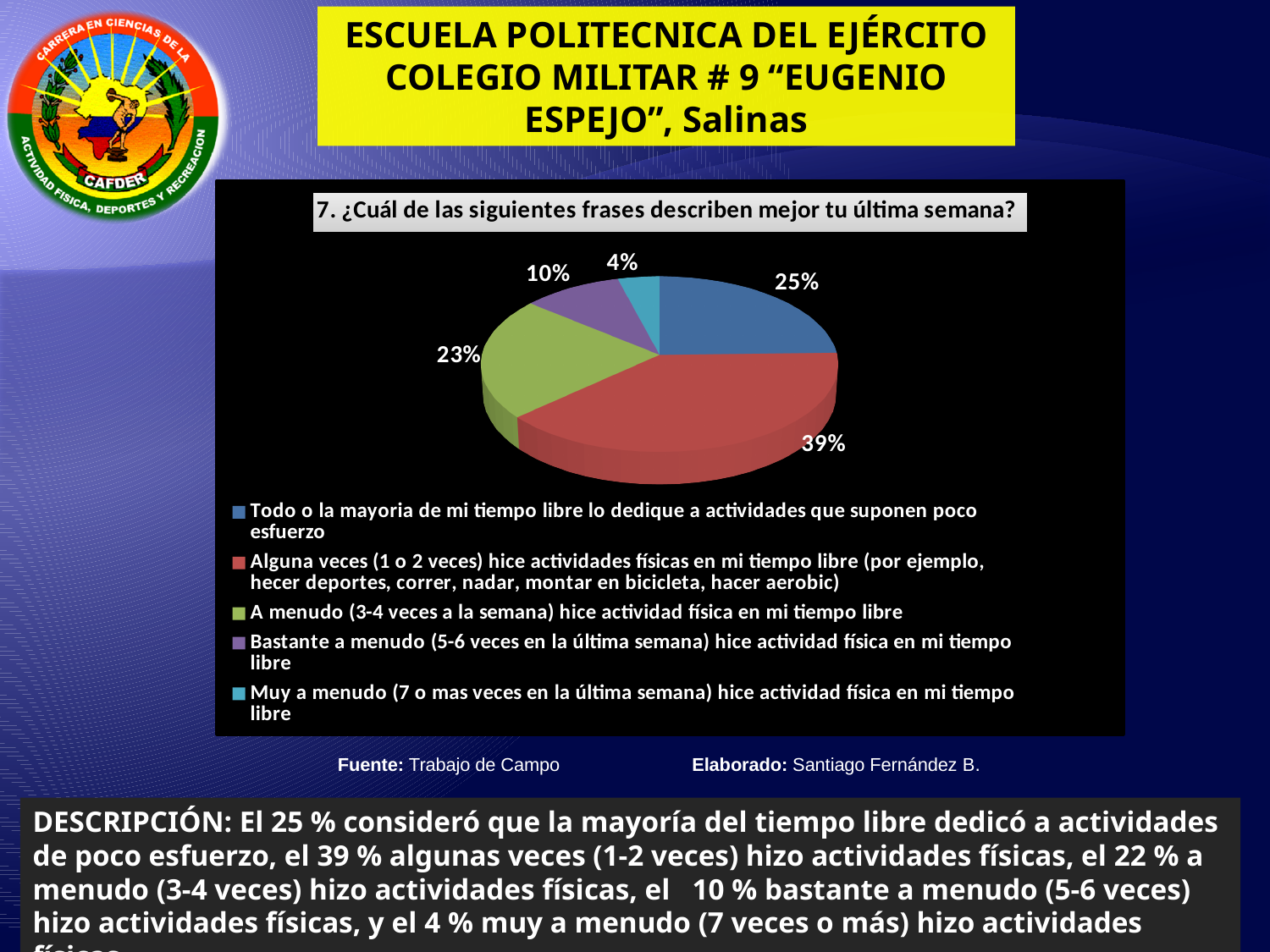
What percentage of the pie corresponds to "Alguna veces (1 o 2 veces) hice actividades físicas en mi tiempo libre"? 39% What percentage of the pie corresponds to "Todo o la mayoria de mi tiempo libre lo dedique a actividades que suponen poco esfuerzo"? 25% What kind of chart is shown on the slide? pie chart Which category has the smallest share of the pie? Muy a menudo (7 o mas veces en la última semana) hice actividad física en mi tiempo libre What is the title of the chart? 7. ¿Cuál de las siguientes frases describen mejor tu última semana? What percentage of the pie corresponds to "A menudo (3-4 veces a la semana) hice actividad física en mi tiempo libre"? 23% Which is larger: the share for "Bastante a menudo (5-6 veces)" or the share for "A menudo (3-4 veces a la semana)"? A menudo (3-4 veces a la semana) What colour is the slice representing "Bastante a menudo (5-6 veces en la última semana)"? purple What is the difference in percentage points between the "Alguna veces (1 o 2 veces)" slice and the "Todo o la mayoria de mi tiempo libre" slice? 14 Which category has the largest share of the pie? Alguna veces (1 o 2 veces) hice actividades físicas en mi tiempo libre How many slices does the pie chart have? 5 What percentage of the pie corresponds to "Muy a menudo (7 o mas veces en la última semana) hice actividad física en mi tiempo libre"? 4%